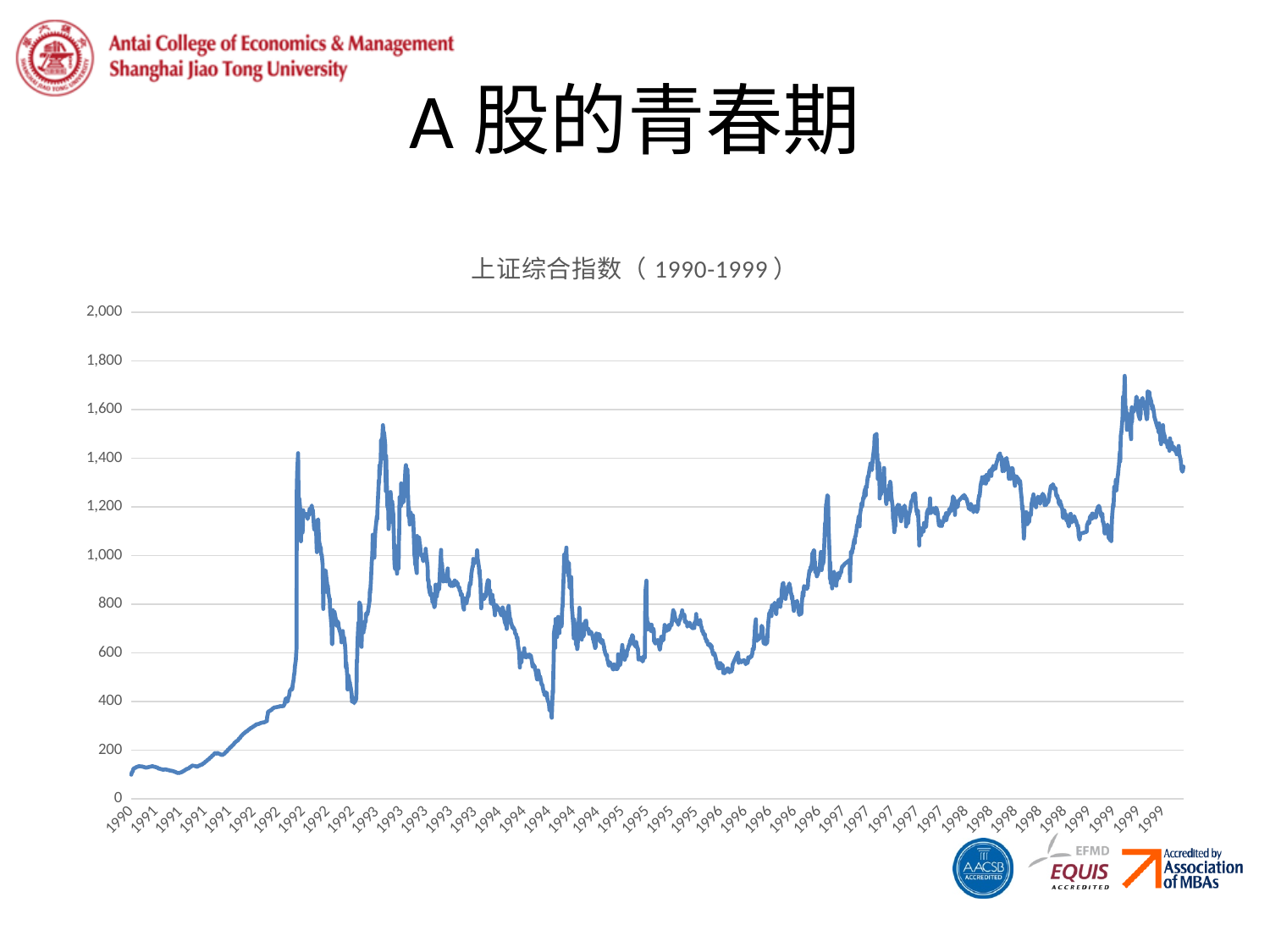
Does the index rise or fall from its 1993 peak to its 1994 low? fall What colour is the line in the chart? blue Does the index rise or fall overall from 1990 to 1999? rise Is the peak value of the index in 1993 greater or less than 1,400? greater Which is higher: the peak of the index in 1993 or the peak in 1999? 1999 Is the peak value of the index in 1999 greater or less than 1,600? greater In which year does the index reach its highest value in the chart? 1999 What kind of chart is shown on the slide? line chart In which year is the index at its lowest value in the chart? 1990 What is the title of the chart? 上证综合指数（1990-1999） Is the lowest value of the index in 1994 greater or less than 400? less